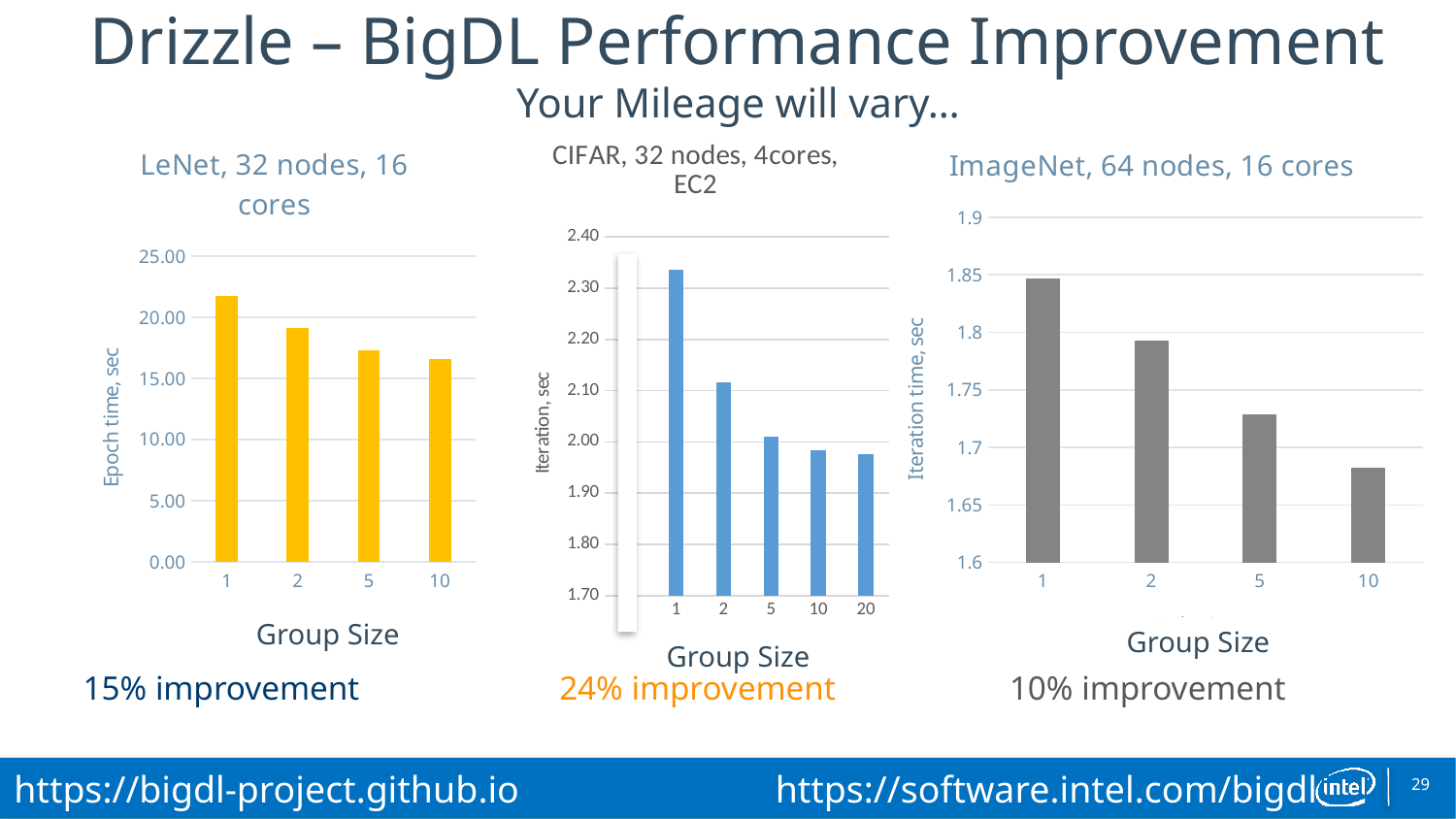
In the ImageNet chart, is the iteration time for group size 10 greater or less than 1.7? less In the CIFAR chart, is the iteration time for group size 20 greater or less than 2.10? less In the ImageNet chart, which is larger, the iteration time for group size 2 or group size 5? group size 2 In the LeNet chart, which group size has the highest epoch time? 1 In the CIFAR chart, is the iteration time for group size 1 greater or less than 2.20? greater What type of chart is the LeNet chart? bar chart In the CIFAR chart, do iteration times rise or fall as group size increases? fall In the CIFAR chart, how many group sizes are plotted? 5 In the LeNet chart, how many group sizes are plotted? 4 In the ImageNet chart, which group size has the lowest iteration time? 10